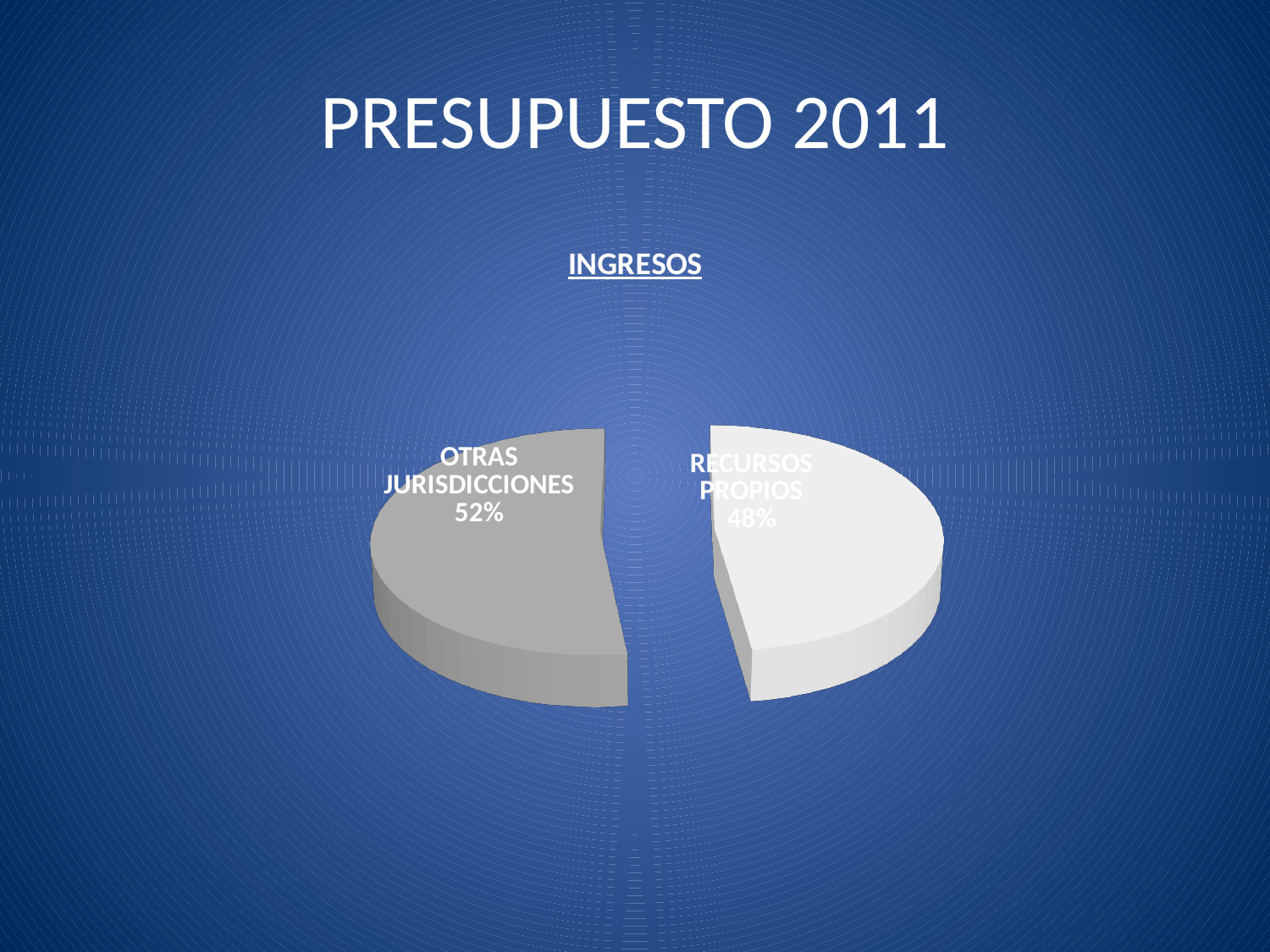
What is the title of the chart? INGRESOS What is the combined share of the two slices in the pie chart? 100% What share of the pie does RECURSOS PROPIOS represent? 48% Which slice of the pie is the smallest? RECURSOS PROPIOS What share of the pie does OTRAS JURISDICCIONES represent? 52% How many slices does the pie chart have? 2 What kind of chart is shown on the slide? Pie chart What is the difference in percentage points between OTRAS JURISDICCIONES and RECURSOS PROPIOS? 4 percentage points Is the share for OTRAS JURISDICCIONES greater or less than 50%? greater Is the share for RECURSOS PROPIOS greater or less than 50%? less Which slice of the pie is the largest? OTRAS JURISDICCIONES Which is larger, OTRAS JURISDICCIONES or RECURSOS PROPIOS? OTRAS JURISDICCIONES